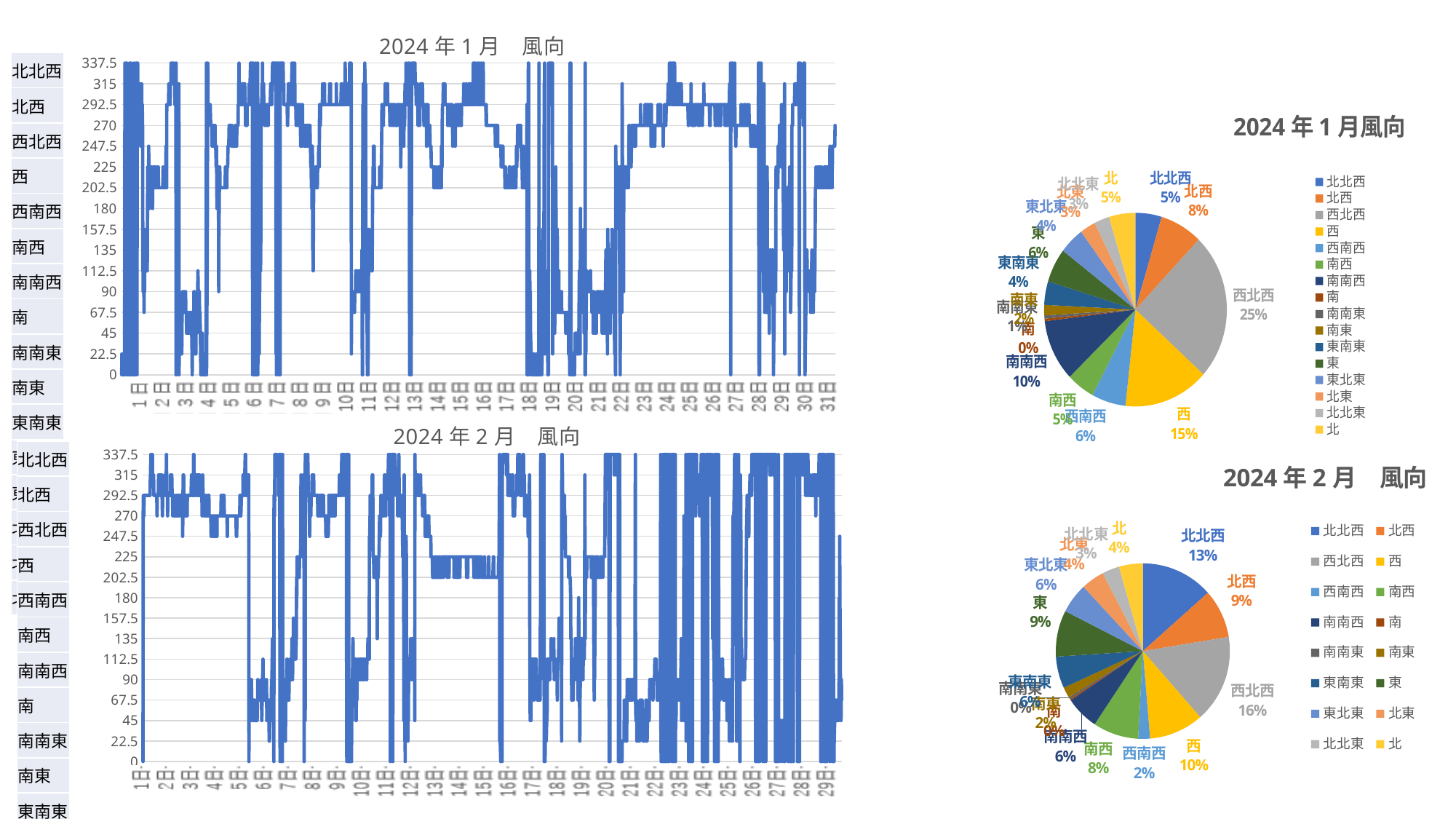
How many days are shown on the x axis of the 2024年2月 風向 line chart? 29 How many entries does the legend of the 2024年1月風向 pie chart list? 16 In the 2024年2月 風向 pie chart, which wind direction has the largest share? 西北西 In the 2024年1月風向 pie chart, which wind direction has the largest share? 西北西 In the 2024年1月風向 pie chart, which is larger, 西 or 北西? 西 In the 2024年1月風向 pie chart, what share does 南南西 have? 10% What kind of chart is the top-left chart titled 2024年1月 風向? line chart In the 2024年2月 風向 pie chart, which is larger, 南西 or 西南西? 南西 In the 2024年1月風向 pie chart, what share does 西北西 have? 25% In the 2024年2月 風向 pie chart, what is the difference in percentage points between 西北西 and 北北西? 3 In the 2024年2月 風向 pie chart, what share does 西北西 have? 16% In the 2024年2月 風向 pie chart, what share does 北北西 have? 13%